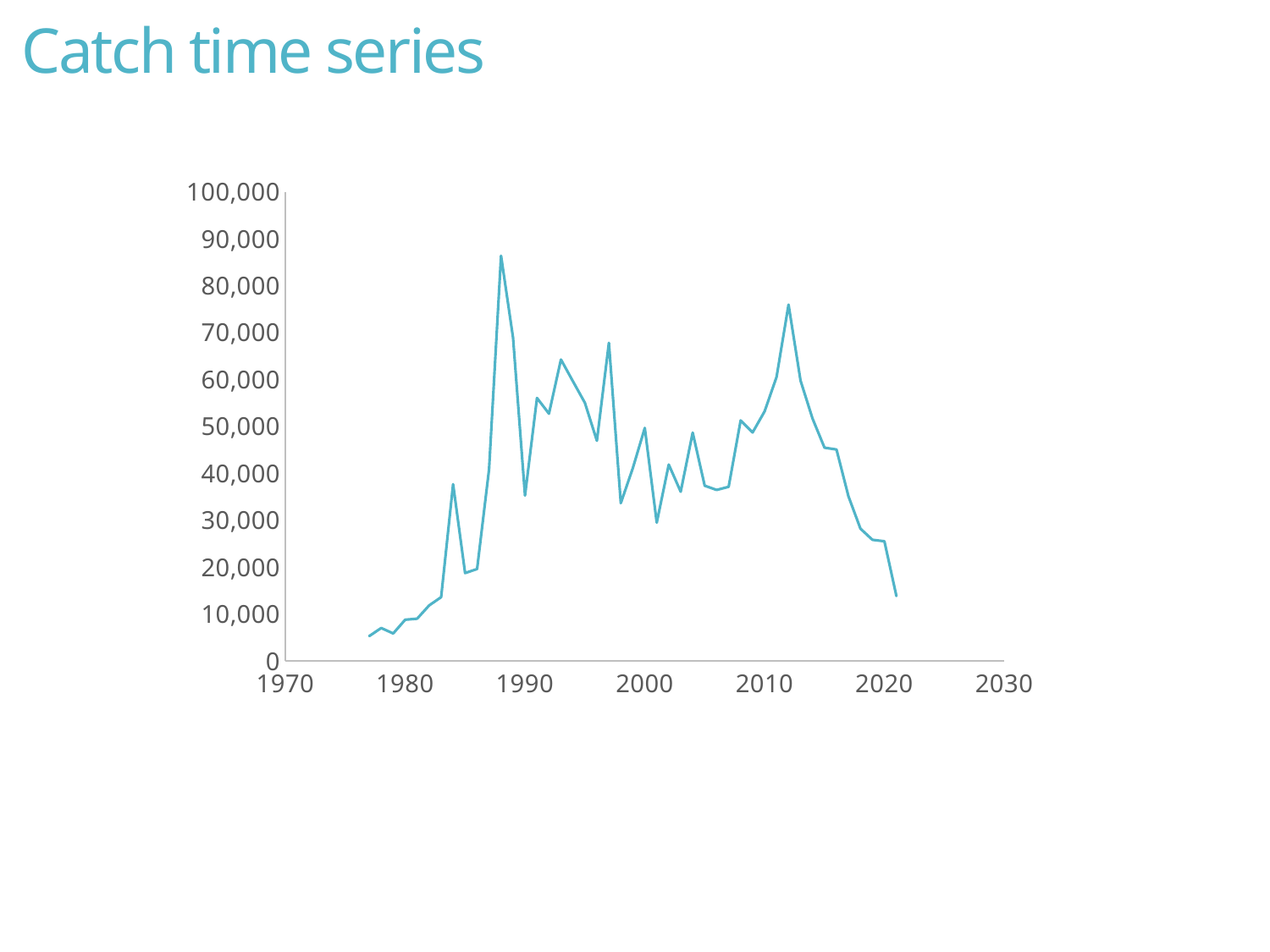
How many lines (series) are plotted on the chart? 1 Is the peak value around 2012 greater or less than 70,000? greater What is the maximum value shown on the vertical axis? 100,000 Do the values generally rise or fall between 2012 and the end of the series? fall Which peak is higher: the one shortly before 1990 or the one around 2012? the one shortly before 1990 Is the highest value on the line greater or less than 80,000? greater What is the title of the chart? Catch time series What kind of chart is shown on the slide? line chart Is the value at the last point of the line (around 2021) greater or less than 20,000? less Does the highest peak of the line occur before or after 1990? before Do the values generally rise or fall from the start of the series to the peak shortly before 1990? rise